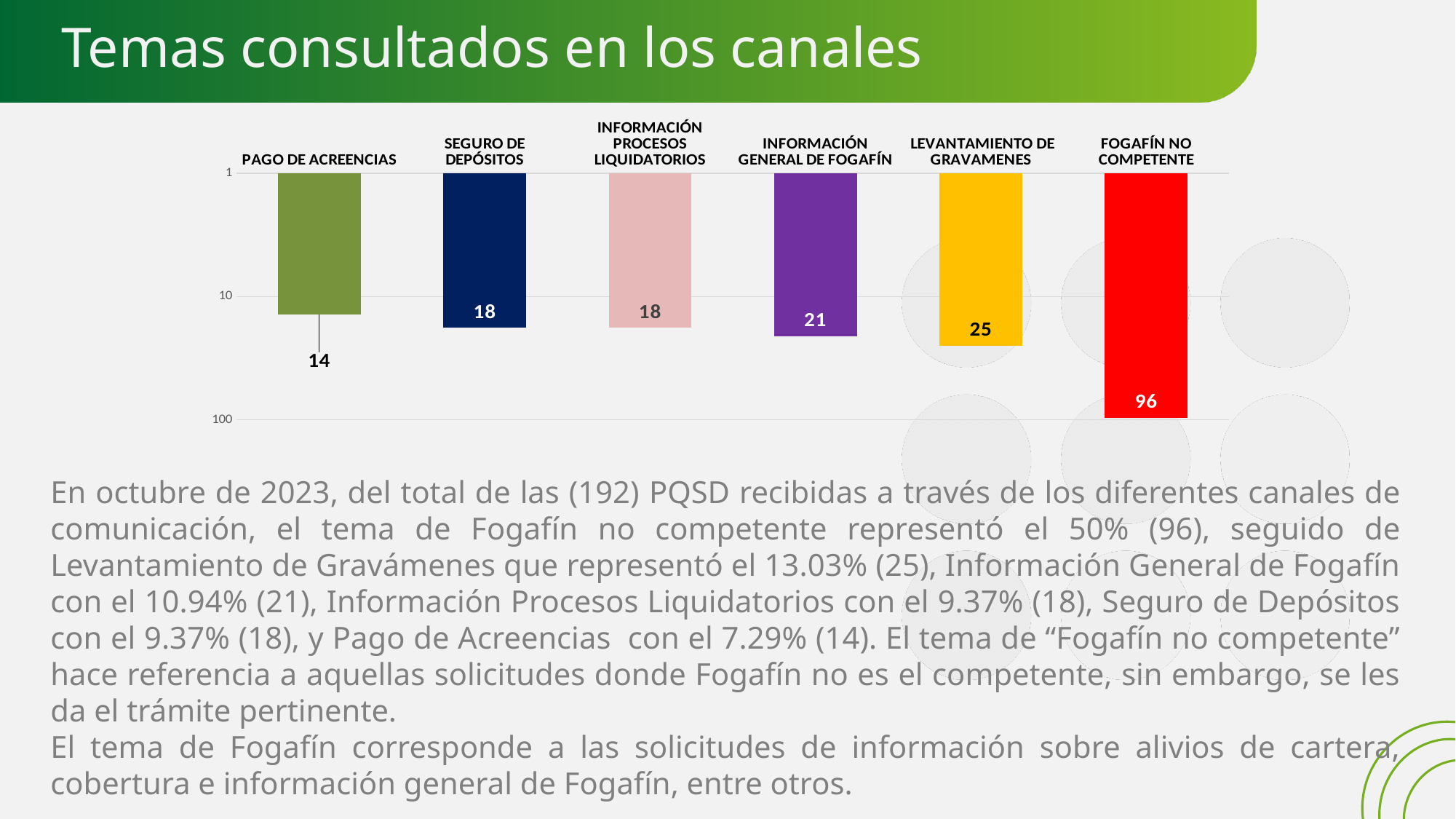
Which category has the lowest value? PAGO DE ACREENCIAS What is the value for INFORMACIÓN GENERAL DE FOGAFÍN? 21 What is the difference between the values for INFORMACIÓN GENERAL DE FOGAFÍN and PAGO DE ACREENCIAS? 7 How many categories are shown in the chart? 6 Which category has the highest value? FOGAFÍN NO COMPETENTE Which is larger, the value for SEGURO DE DEPÓSITOS or the value for LEVANTAMIENTO DE GRAVAMENES? LEVANTAMIENTO DE GRAVAMENES What is the value for LEVANTAMIENTO DE GRAVAMENES? 25 What is the value for FOGAFÍN NO COMPETENTE? 96 What is the value for PAGO DE ACREENCIAS? 14 What is the difference between the values for FOGAFÍN NO COMPETENTE and LEVANTAMIENTO DE GRAVAMENES? 71 What colour is the bar for FOGAFÍN NO COMPETENTE? Red What kind of chart is shown on the slide? Bar chart